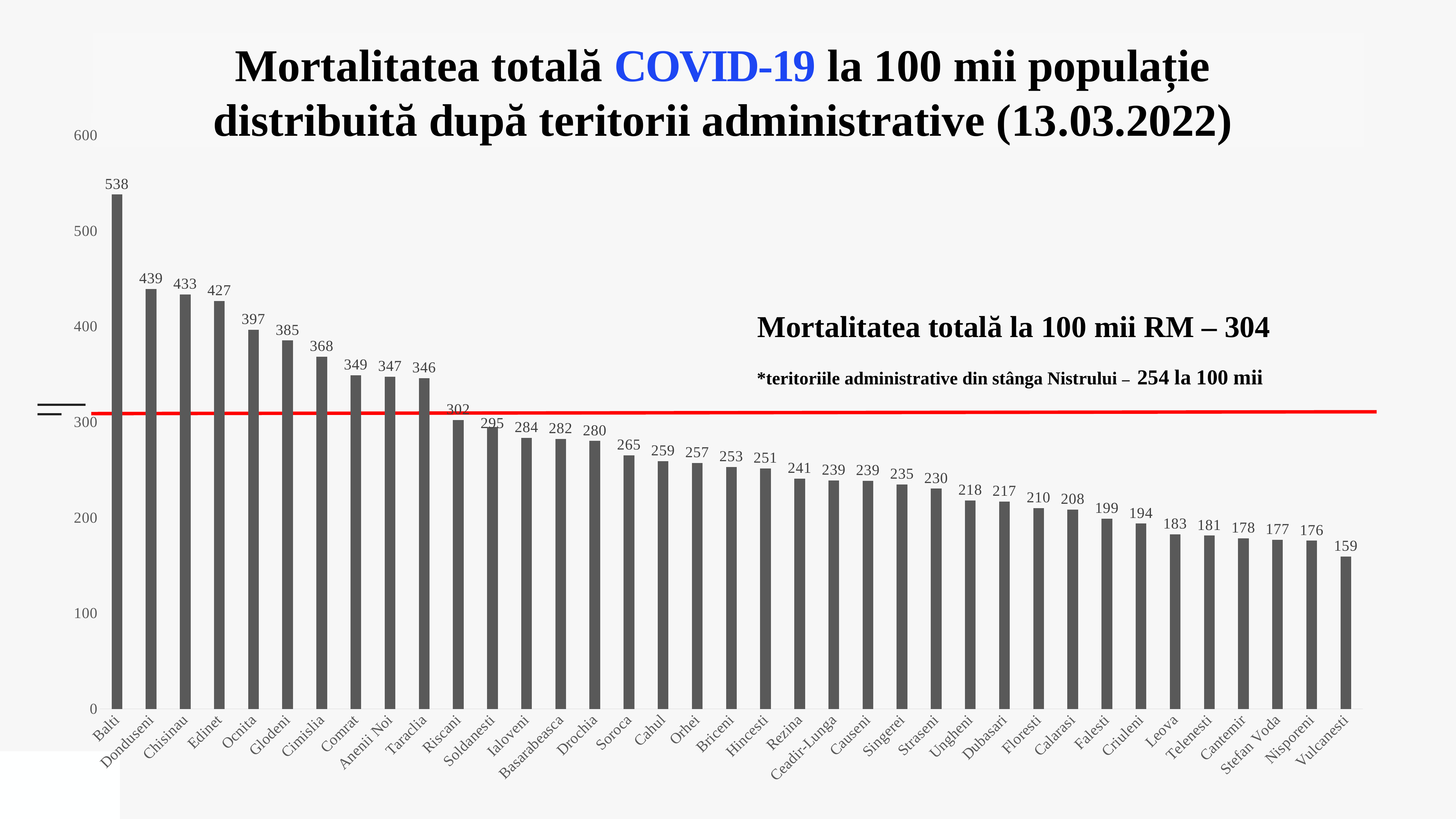
What is the difference between the values for Balti and Donduseni? 99 What is the value for Cahul? 259 Do the values rise or fall from left to right along the x axis? fall What kind of chart is shown on the slide? bar chart What is the value for Chisinau? 433 What is the value for Ungheni? 218 What is the value for Balti? 538 Which territory has the lowest value? Vulcanesti Which territory has the highest value? Balti How many territories are shown on the chart? 37 Which is larger, the value for Ocnita or the value for Glodeni? Ocnita What is the difference between the values for Riscani and Vulcanesti? 143